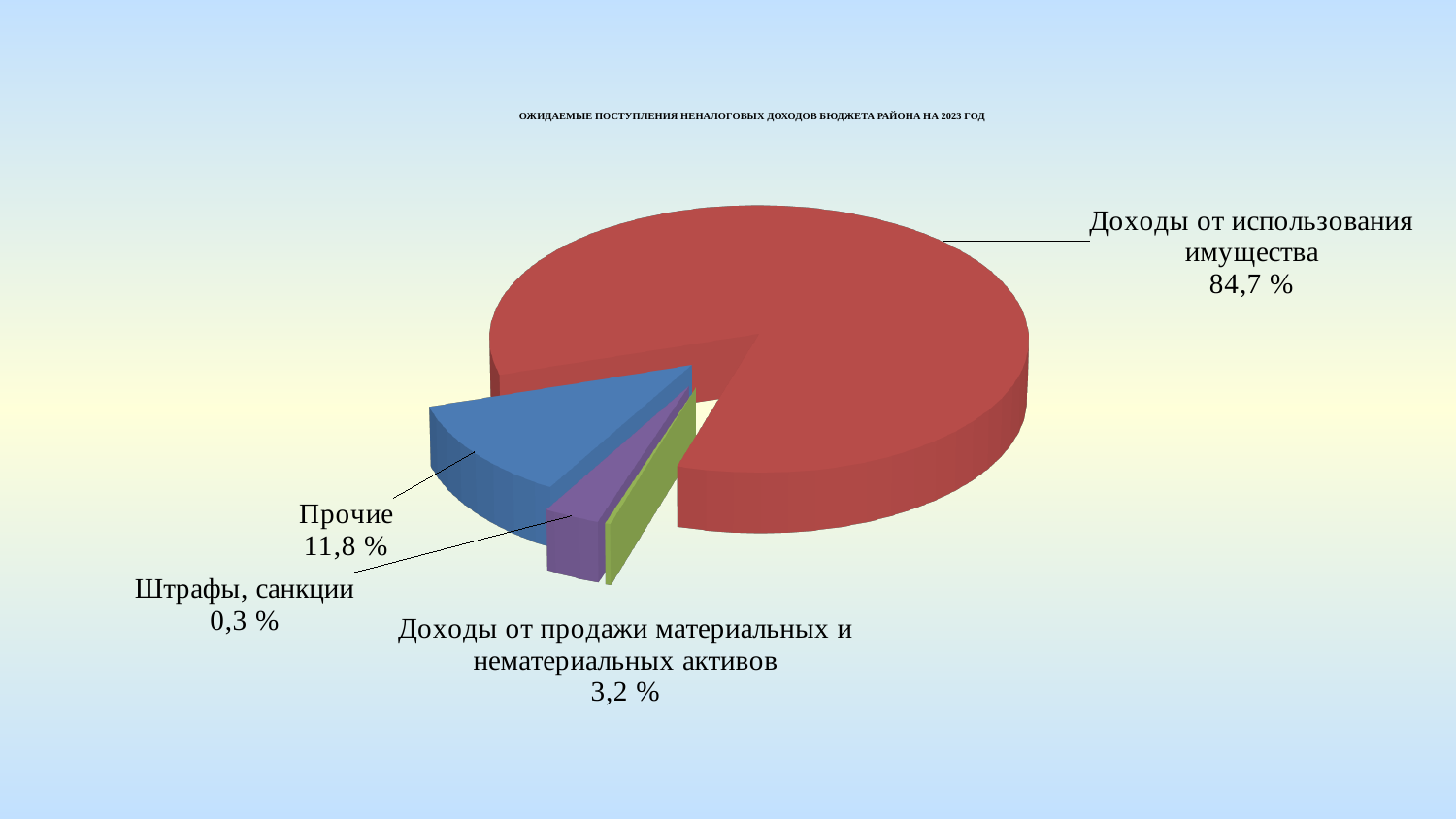
How many slices does the pie chart have? 4 What share of the pie does Прочие have? 11,8 % What share of the pie does Штрафы, санкции have? 0,3 % What share of the pie does Доходы от использования имущества have? 84,7 % What share of the pie does Доходы от продажи материальных и нематериальных активов have? 3,2 % Which is larger: the share of Прочие or the share of Доходы от продажи материальных и нематериальных активов? Прочие Which category has the smallest share of the pie? Штрафы, санкции Which category has the largest share of the pie? Доходы от использования имущества What kind of chart is shown on the slide? Pie chart What colour is the slice for Доходы от использования имущества? Red What is the difference between the shares of Доходы от использования имущества and Прочие? 72,9 % What is the difference between the shares of Доходы от продажи материальных и нематериальных активов and Штрафы, санкции? 2,9 %